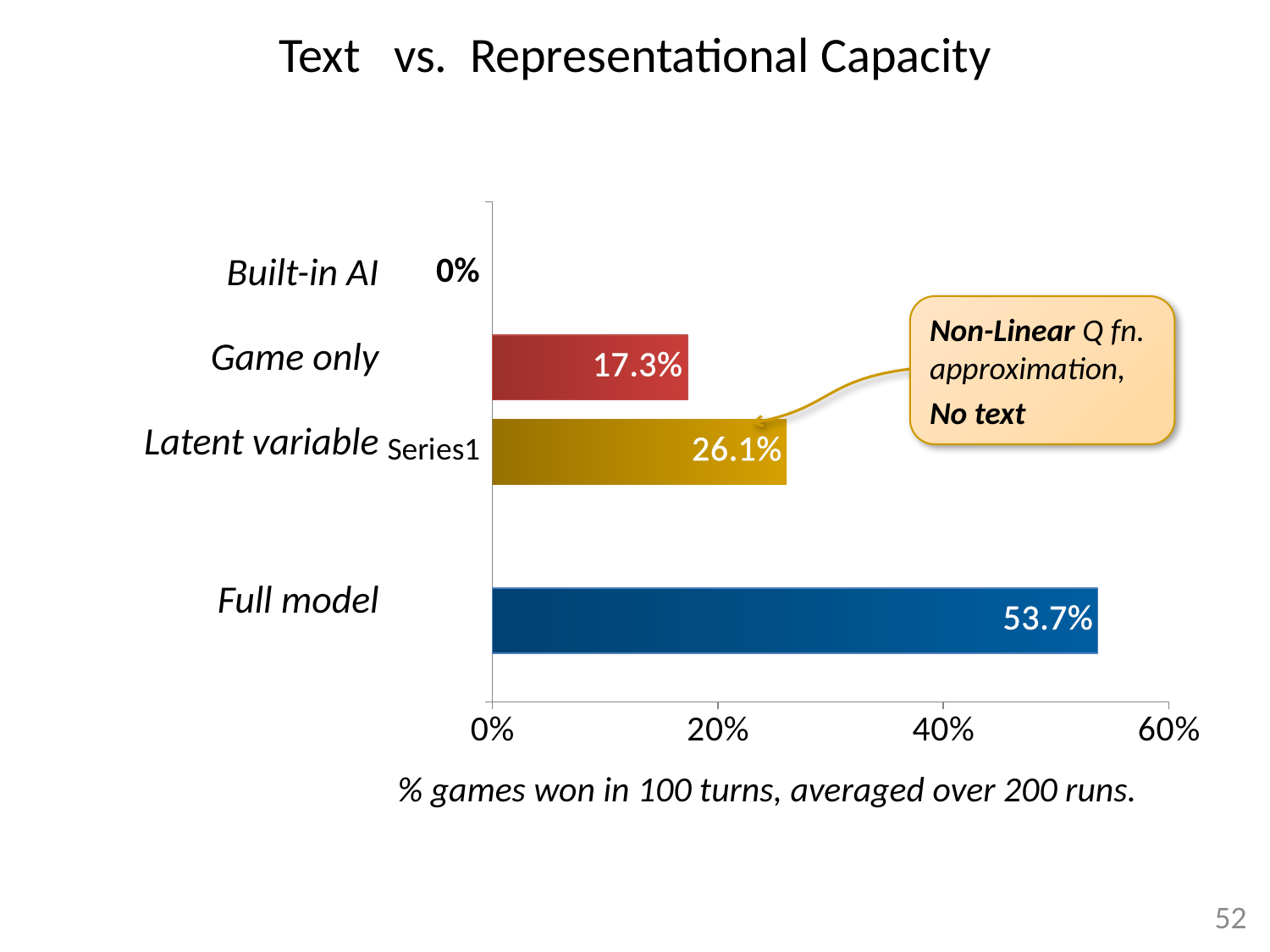
What is the value for Built-in AI? 0% What is the difference between the Full model and Latent variable values? 27.6% Which category has the highest value? Full model How many categories are shown in the chart? 4 Which is larger, the value for Game only or the value for Latent variable? Latent variable What is the difference between the Latent variable and Game only values? 8.8% What is the value for Game only? 17.3% What kind of chart is shown on the slide? bar chart Which category has the lowest value? Built-in AI What is the value for Latent variable? 26.1% Is the value for Full model greater or less than 40%? greater What is the value for Full model? 53.7%